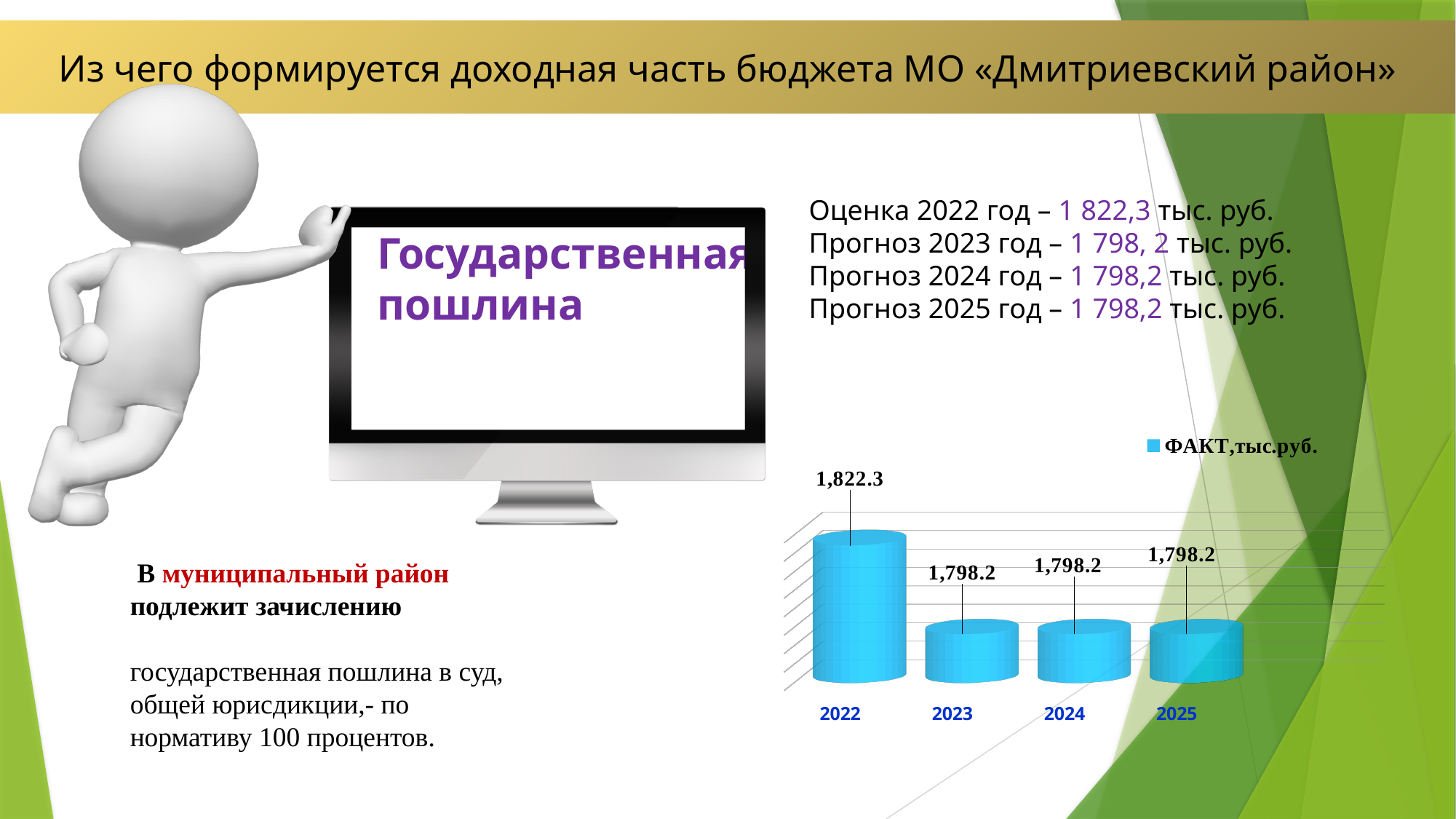
What kind of chart is shown on the slide? Bar chart Which is larger, the value for 2022 or the value for 2024? 2022 What is the value for 2025 in the chart? 1,798.2 Are the values for 2023 and 2024 equal? Yes How many series does the chart legend list? 1 What is the value for 2022 in the chart? 1,822.3 What is the difference between the values for 2022 and 2023? 24.1 Which year has the highest value in the chart? 2022 What is the legend entry of the chart? ФАКТ,тыс.руб. What is the value for 2023 in the chart? 1,798.2 How many years are shown on the x axis of the chart? 4 Does the value rise or fall from 2022 to 2023? Fall